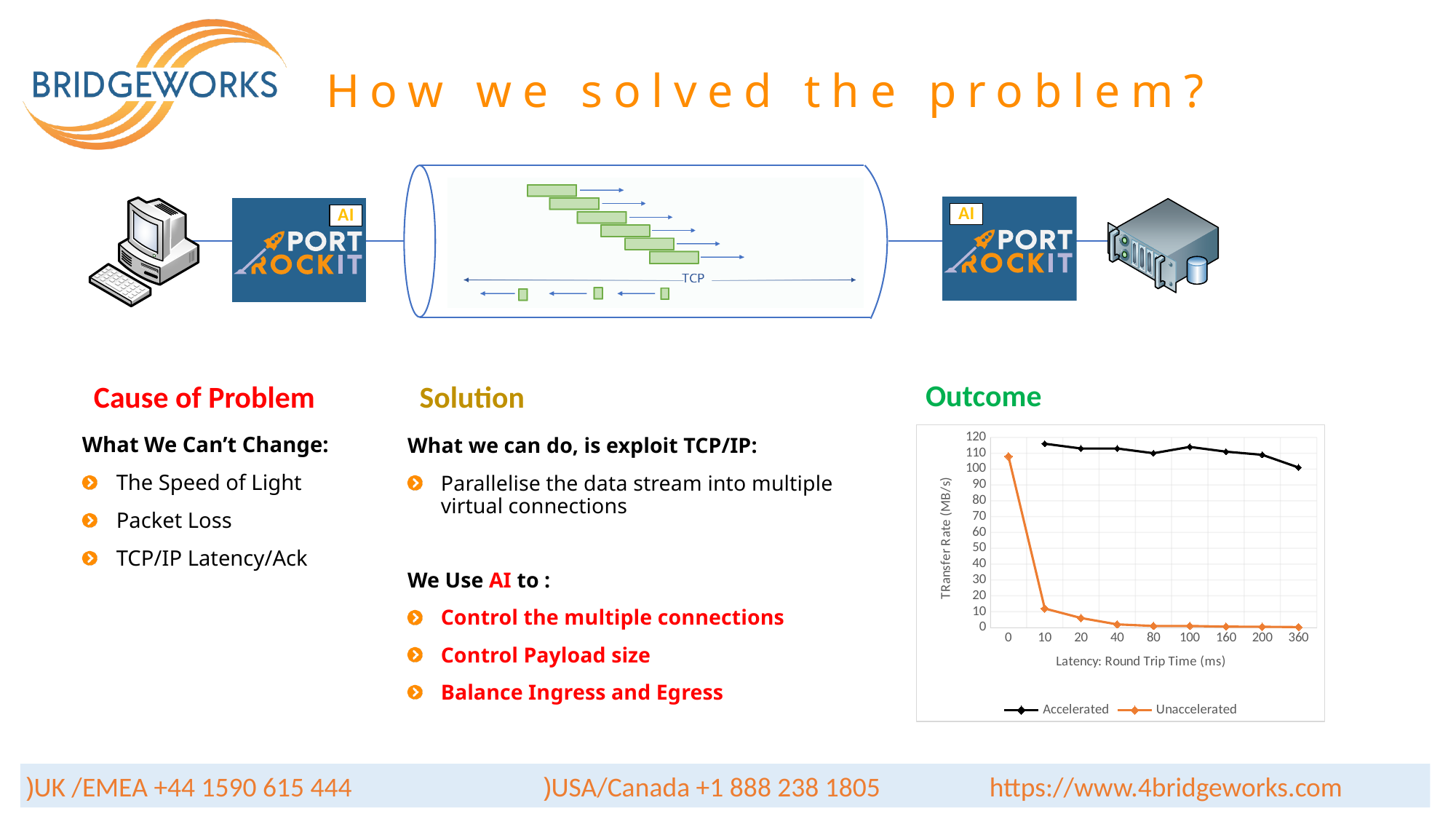
In the Outcome chart, at which latency value is the Accelerated transfer rate lowest? 360 What is the x-axis title of the Outcome chart? Latency: Round Trip Time (ms) In the Outcome chart, at which latency value is the Unaccelerated transfer rate highest? 0 In the Outcome chart, is the Unaccelerated transfer rate at 10 ms latency greater or less than 20 MB/s? less How many series does the legend of the Outcome chart list? 2 In the Outcome chart, which series has the higher transfer rate at 80 ms latency, Accelerated or Unaccelerated? Accelerated In the Outcome chart, which series is drawn in orange? Unaccelerated How many latency values are marked along the x axis of the Outcome chart? 9 In the Outcome chart, does the Unaccelerated transfer rate rise or fall as latency increases? fall In the Outcome chart, is the Unaccelerated transfer rate at 0 ms latency greater or less than 100 MB/s? greater What kind of chart is shown under the Outcome heading? line chart In the Outcome chart, is the Accelerated transfer rate at 10 ms latency greater or less than 100 MB/s? greater